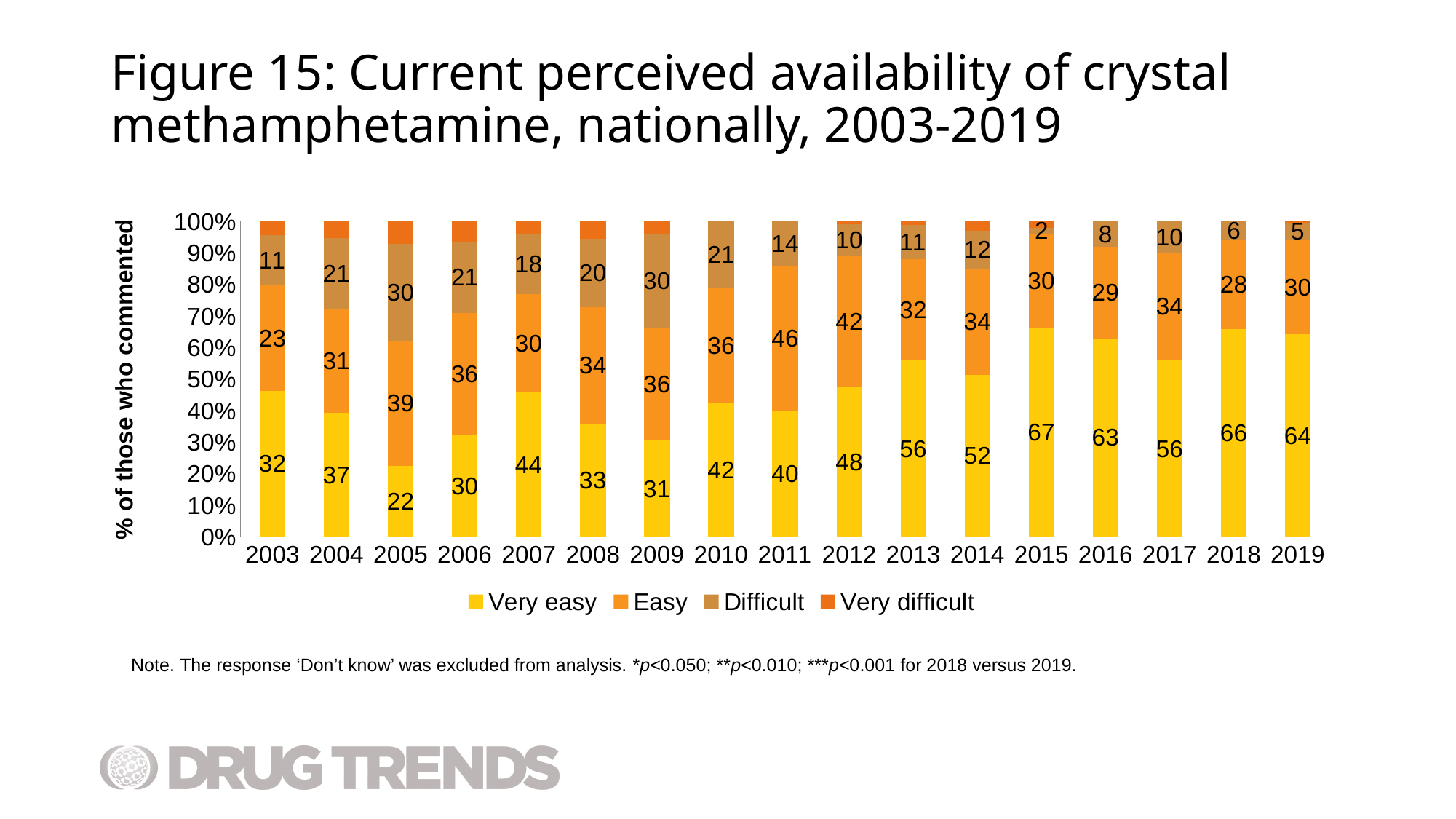
Which year has the larger 'Easy' value, 2011 or 2012? 2011 In which year was the 'Very easy' value highest? 2015 What is the 'Easy' value for 2011? 46 In which year was the 'Very easy' value lowest? 2005 How many years are shown on the x axis? 17 What is the 'Difficult' value shown for 2005? 30 What is the difference between the 'Very easy' values for 2019 and 2003? 32 How many series does the legend list? 4 What kind of chart is shown on the slide? Stacked bar chart Is the 'Very easy' segment for 2015 greater or less than 60%? greater In which year was the 'Difficult' value lowest? 2015 What percentage of respondents rated crystal methamphetamine as 'Very easy' to obtain in 2015? 67